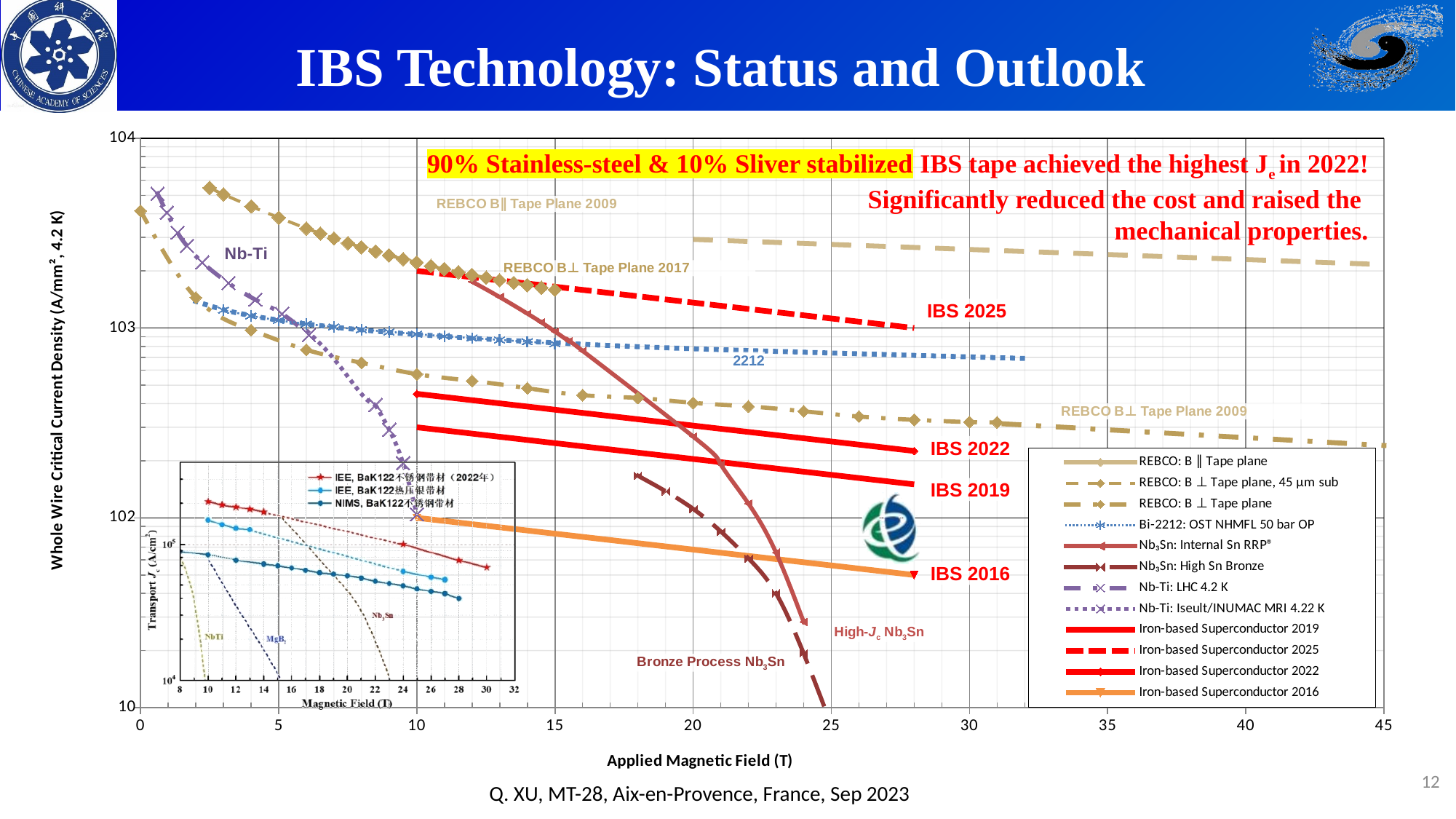
In the main chart, at 20 T, which is higher: Iron-based Superconductor 2022 or Iron-based Superconductor 2019? Iron-based Superconductor 2022 In the main chart, is the value for Iron-based Superconductor 2022 at 10 T greater or less than 10³? less How many series does the legend of the inset chart list? 3 In the main chart, is the value for REBCO: B ∥ Tape plane at 30 T greater or less than 10³? greater What kind of chart is the main chart on the slide? line chart In the main chart, is the value for Iron-based Superconductor 2016 at 25 T greater or less than 10²? less What is the title of the x axis of the main chart? Applied Magnetic Field (T) In the main chart, at 25 T, which is higher: Iron-based Superconductor 2025 or Iron-based Superconductor 2022? Iron-based Superconductor 2025 In the main chart, do the values of the Iron-based Superconductor 2022 line rise or fall as the applied magnetic field increases? fall What is the highest value shown on the x axis of the main chart? 45 In the main chart, at 20 T, which is higher: REBCO: B ∥ Tape plane or Bi-2212: OST NHMFL 50 bar OP? REBCO: B ∥ Tape plane How many series does the legend of the main chart list? 12